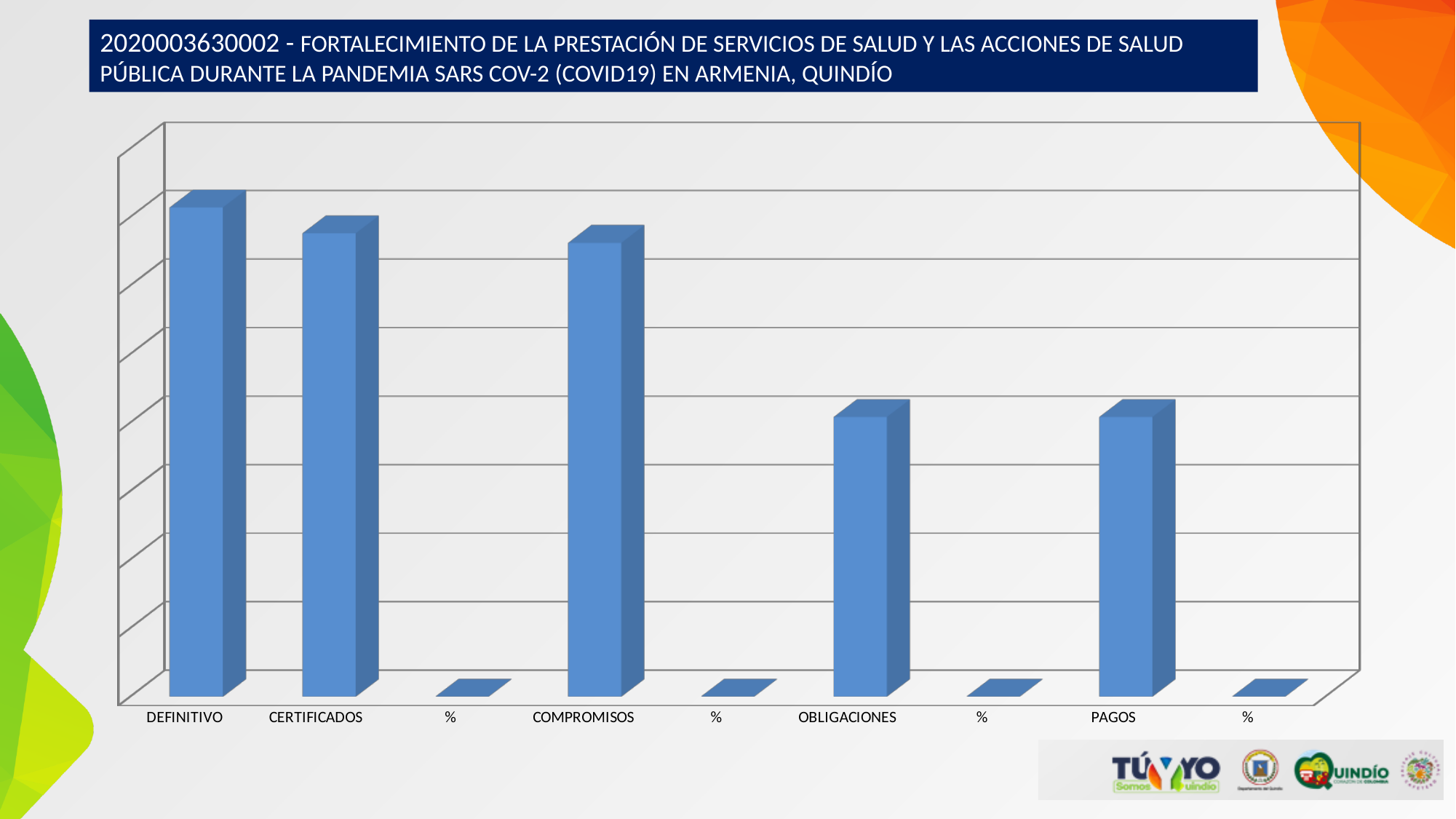
Which bar is taller, DEFINITIVO or PAGOS? DEFINITIVO What is the label of the first category on the x axis of the chart? DEFINITIVO Which bar is taller, CERTIFICADOS or PAGOS? CERTIFICADOS What colour are the bars in the chart? blue How many categories are shown on the x axis of the chart? 9 Which bar is taller, OBLIGACIONES or CERTIFICADOS? CERTIFICADOS What kind of chart is shown on the slide? bar chart Which category has the tallest bar in the chart? DEFINITIVO How many categories on the x axis are labelled "%"? 4